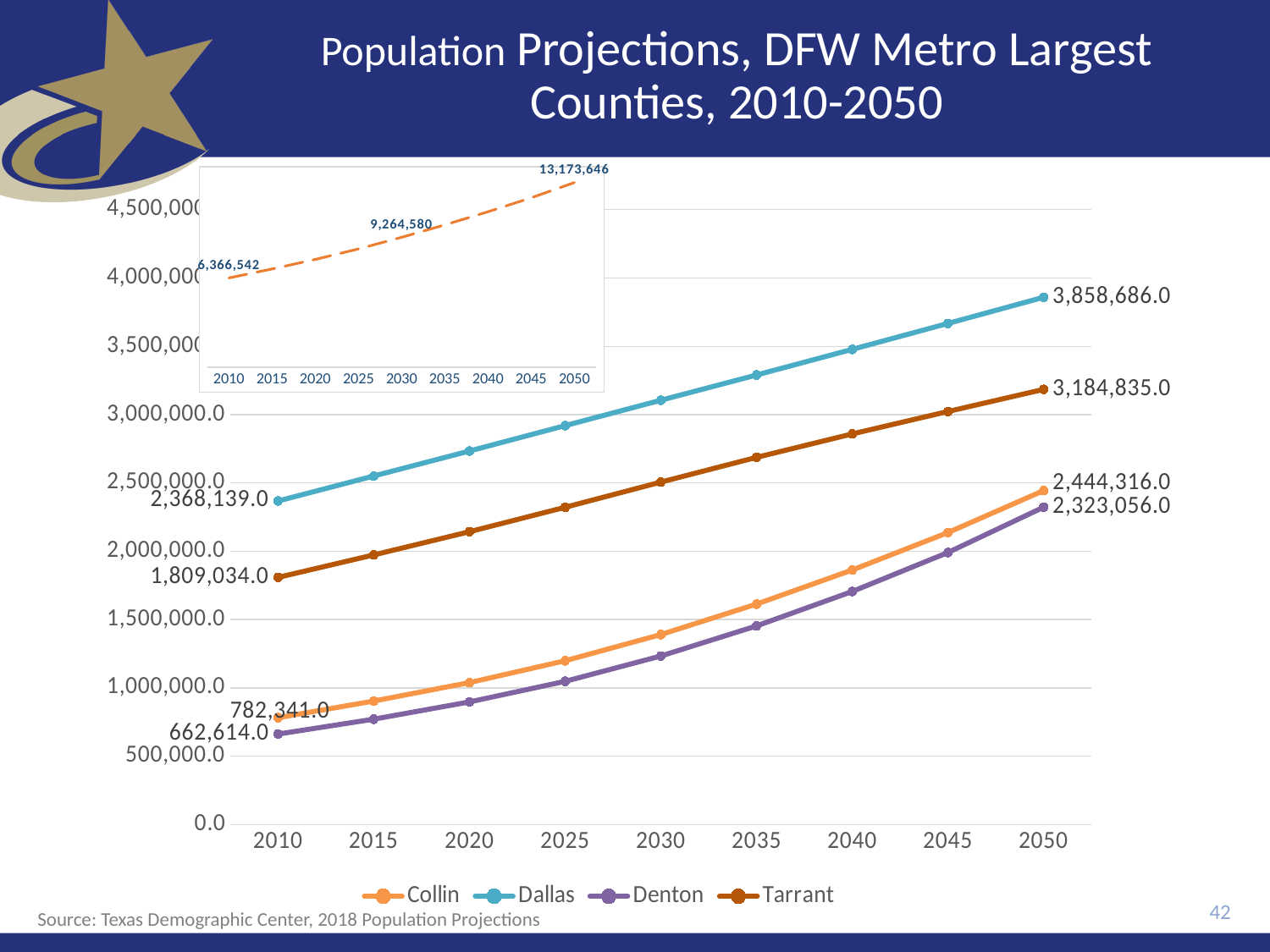
On the main chart, what is the projected population of Dallas County in 2050? 3,858,686.0 On the small inset chart in the upper left, what is the value labelled for 2050? 13,173,646 On the main chart, what is the projected population of Denton County in 2050? 2,323,056.0 On the main chart, what is the population of Tarrant County in 2010? 1,809,034.0 On the main chart, by how much does Dallas County's population grow from 2010 to 2050? 1,490,547.0 On the main chart, is the value for Dallas County in 2030 greater or less than 3,000,000.0? greater What kind of chart is the main chart on the slide? line chart On the main chart, how many series does the legend list? 4 On the main chart, which county has the lowest population in 2010? Denton On the main chart, which is larger in 2050: Collin County or Denton County? Collin On the main chart, how many years are shown on the x axis? 9 On the main chart, which county has the highest projected population in 2050? Dallas